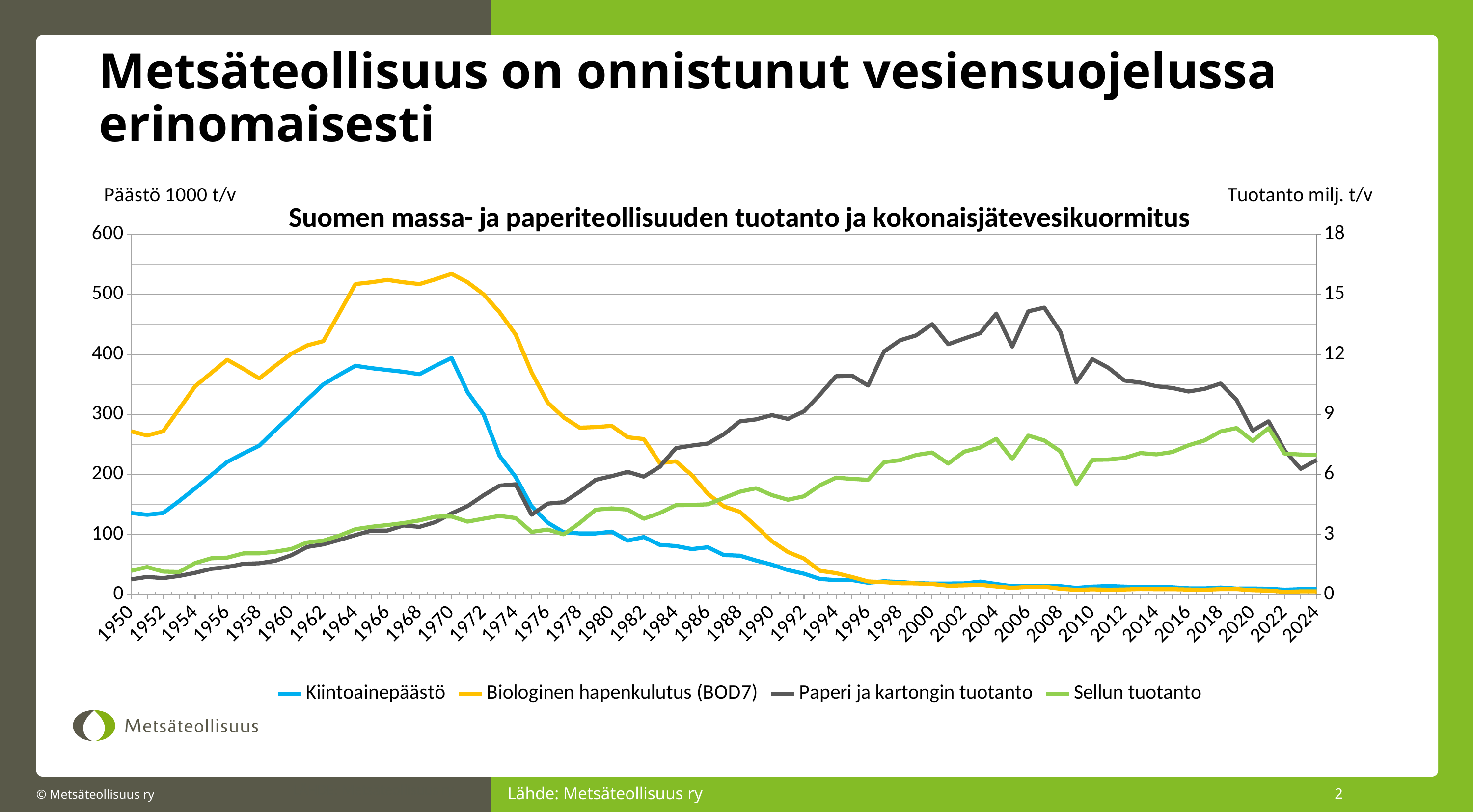
What kind of chart is shown on the slide? line chart Does Kiintoainepäästö rise or fall from 1970 to 2024? fall In 1960, which is higher: Biologinen hapenkulutus (BOD7) or Kiintoainepäästö? Biologinen hapenkulutus (BOD7) Is the value for Biologinen hapenkulutus (BOD7) in 1970 greater or less than 500? greater Is the value for Kiintoainepäästö in 2024 greater or less than 100? less In which year does Biologinen hapenkulutus (BOD7) reach its peak? 1970 Is the value for Paperi ja kartongin tuotanto in 2008 greater or less than 12 on the right axis? greater Which series reaches the highest value on the left axis? Biologinen hapenkulutus (BOD7) What is the label of the left vertical axis? Päästö 1000 t/v What is the title of the chart? Suomen massa- ja paperiteollisuuden tuotanto ja kokonaisjätevesikuormitus How many series does the chart legend list? 4